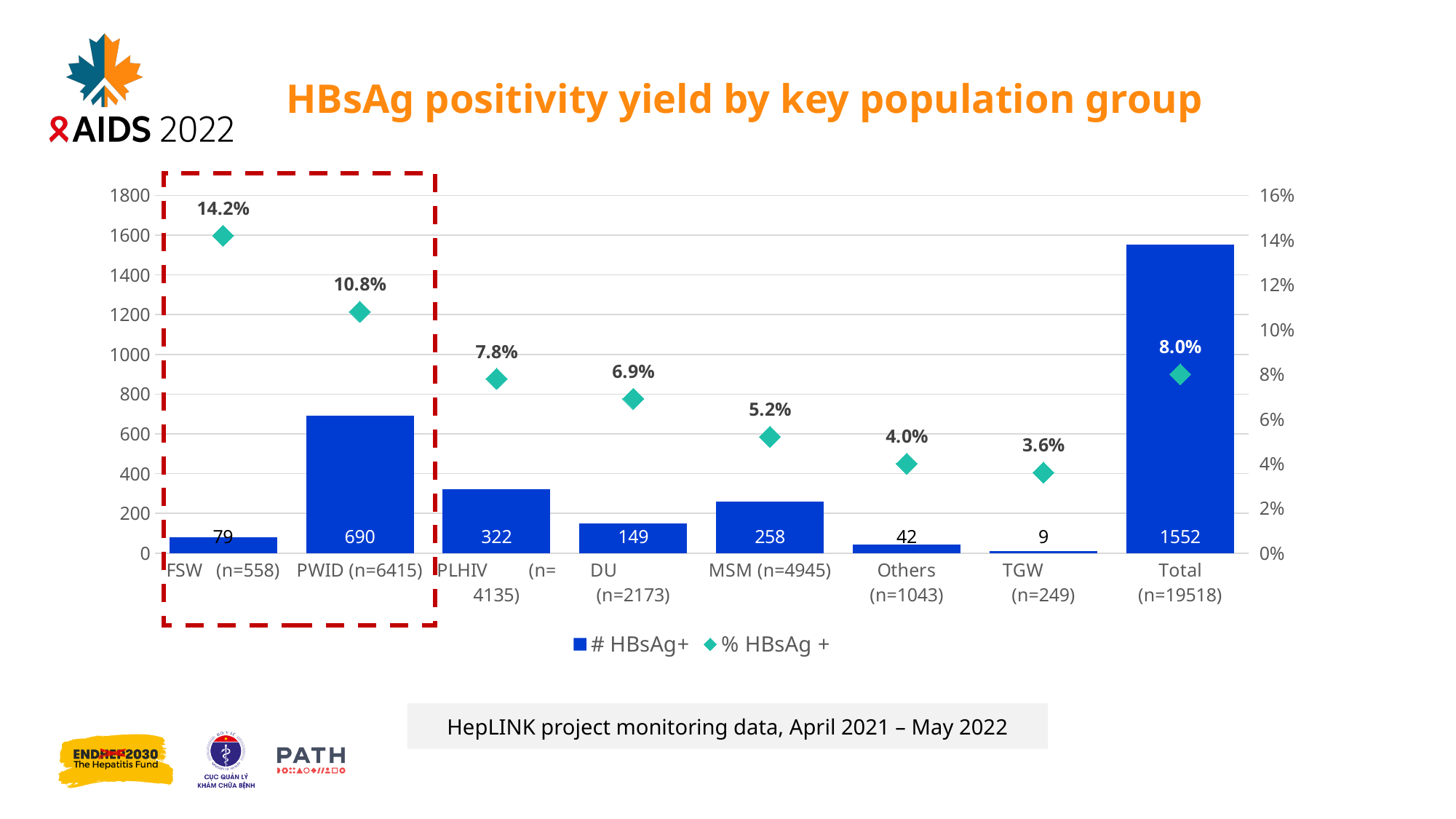
What is the difference in # HBsAg+ between PLHIV and DU? 173 What is the % HBsAg+ value for FSW? 14.2% What is the title of the chart? HBsAg positivity yield by key population group How many series does the legend list? 2 What is the # HBsAg+ value for MSM? 258 What is the # HBsAg+ value for PWID? 690 Which group has the lowest % HBsAg+? TGW Excluding Total, which group has the highest # HBsAg+? PWID How many groups are shown on the x axis, including Total? 8 What kind of chart is this? Combined bar and scatter (marker) chart What is the % HBsAg+ value for TGW? 3.6% Which has a higher % HBsAg+, DU or MSM? DU